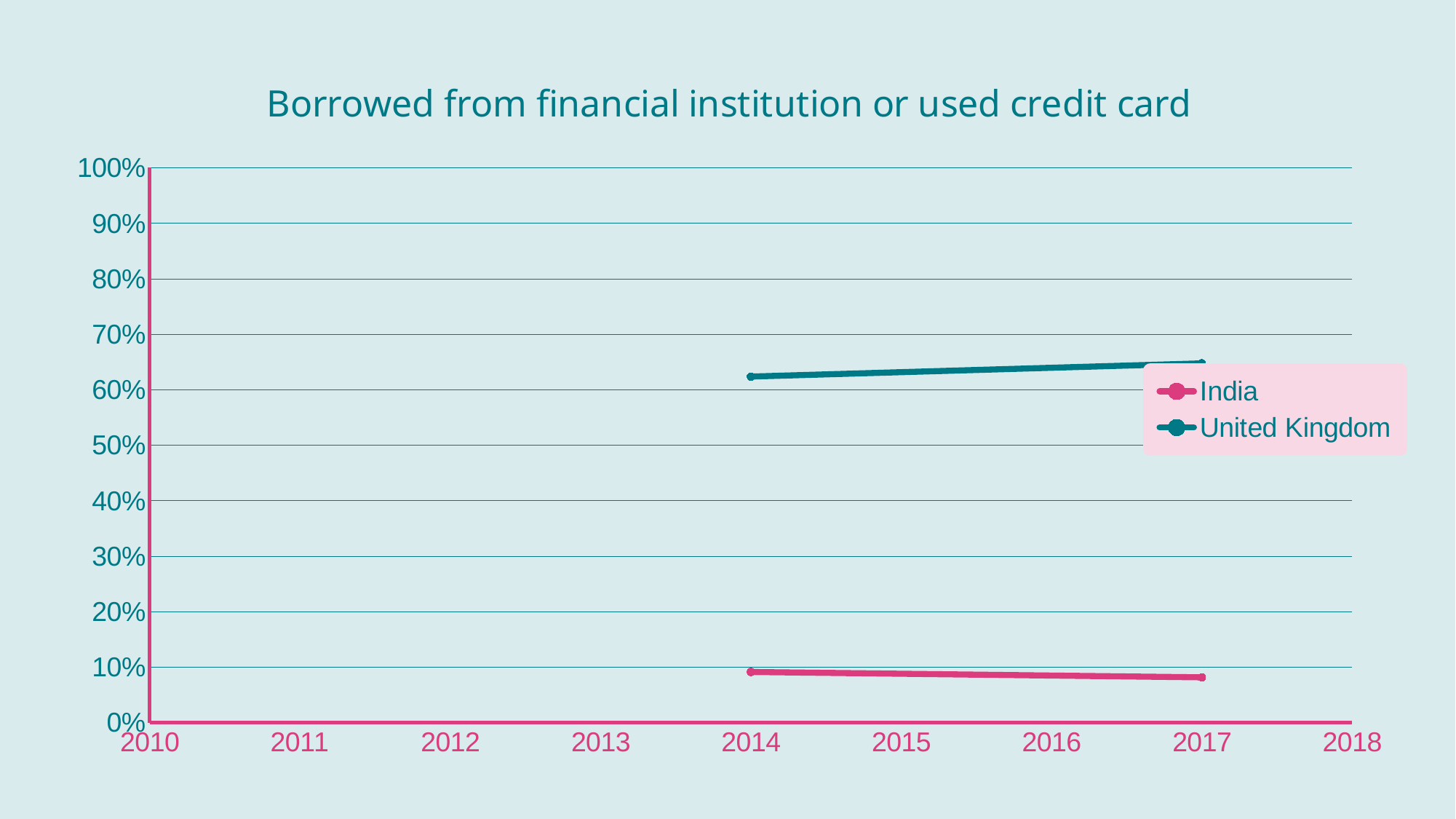
Does the India line rise or fall from 2014 to 2017? fall Which series is drawn in pink? India Is the value for India in 2014 greater or less than 20%? less Which series has the higher values, India or United Kingdom? United Kingdom Is the value for India in 2017 greater or less than 10%? less Does the United Kingdom line rise or fall from 2014 to 2017? rise How many series does the legend list? 2 How many data points are plotted for the United Kingdom series? 2 What kind of chart is shown on the slide? line chart Is the value for United Kingdom in 2014 greater or less than 60%? greater What is the title of the chart? Borrowed from financial institution or used credit card